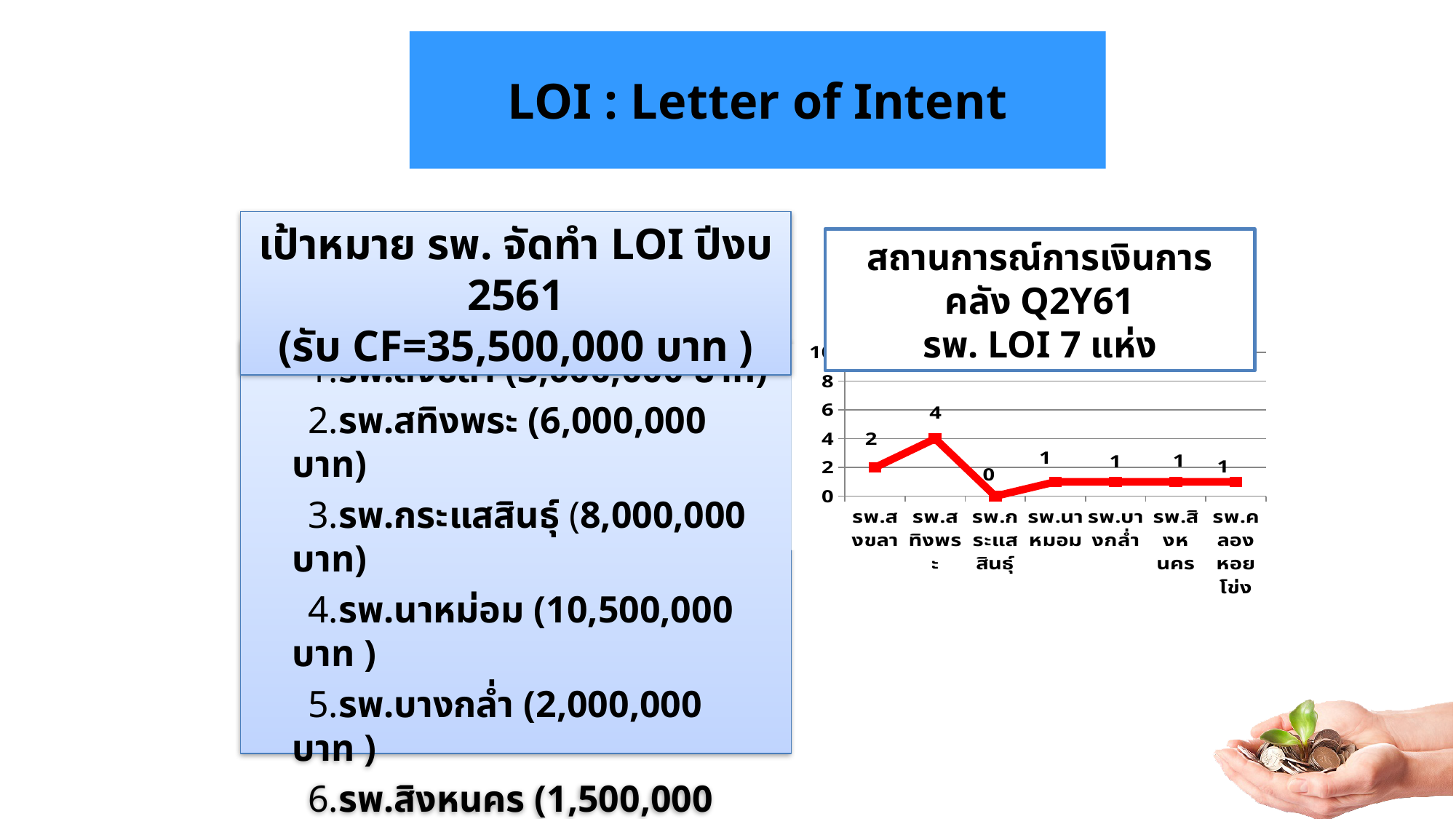
Which has a larger value, รพ.สงขลา or รพ.บางกล่ำ? รพ.สงขลา What is the value for รพ.กระแสสินธุ์ in the chart? 0 Which hospital has the highest value in the chart? รพ.สทิงพระ What is the value for รพ.สทิงพระ in the chart? 4 How many hospitals are plotted on the x axis of the chart? 7 What type of chart is shown on the slide? line chart What is the title of the chart? สถานการณ์การเงินการคลัง Q2Y61 รพ. LOI 7 แห่ง Which hospital has the lowest value in the chart? รพ.กระแสสินธุ์ What is the value for รพ.นาหม่อม in the chart? 1 What is the difference between the values for รพ.สทิงพระ and รพ.สงขลา? 2 Is the value for รพ.สทิงพระ greater or less than 6? less What is the value for รพ.สงขลา in the chart? 2